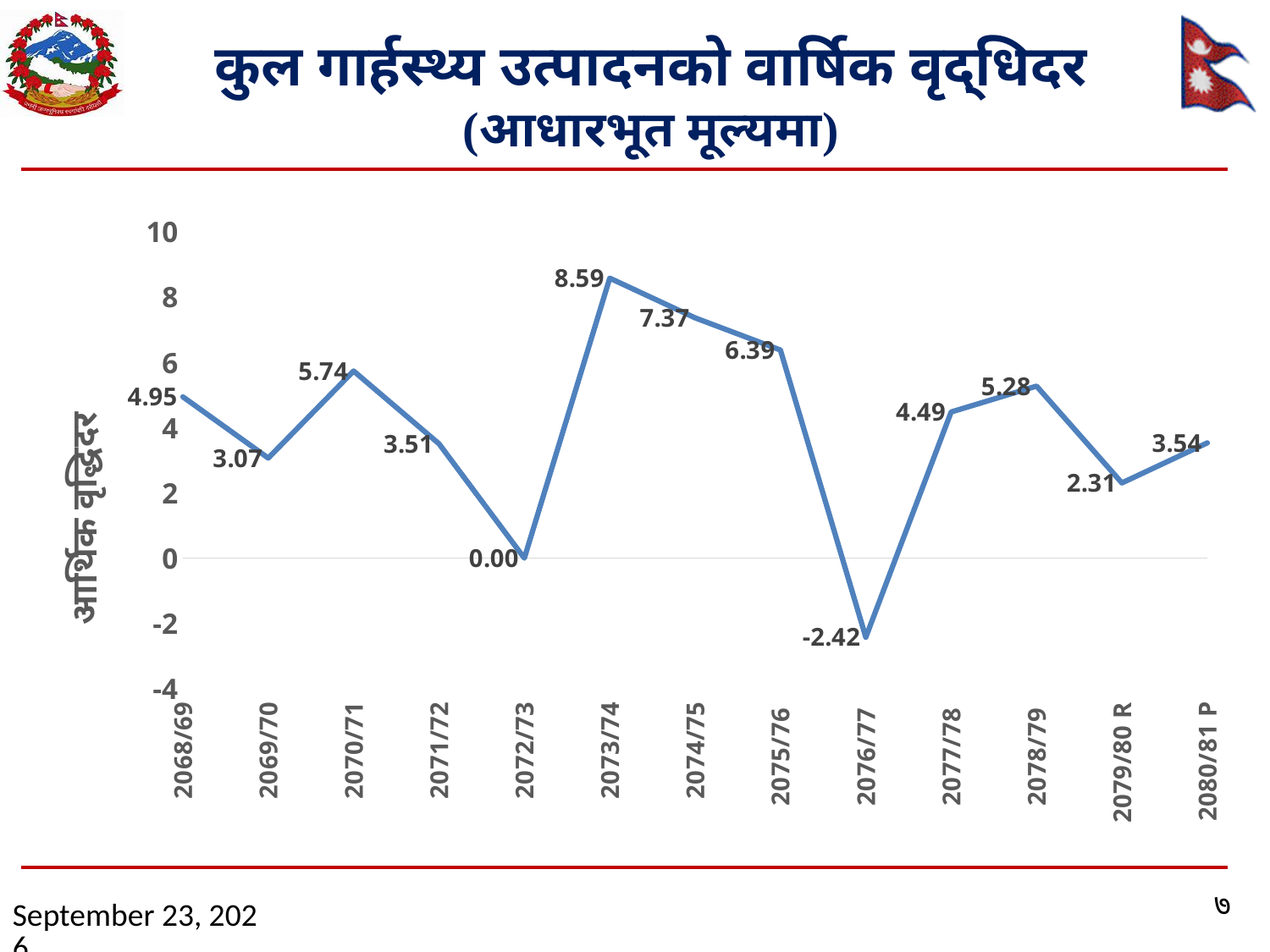
How many years are plotted on the x axis? 13 Which year has the lowest value? 2076/77 Do the values rise or fall from 2079/80 R to 2080/81 P? rise What is the value for 2080/81 P? 3.54 Is the value for 2075/76 greater or less than 6? greater Which year has the highest value? 2073/74 What is the difference between the values for 2073/74 and 2074/75? 1.22 What is the value for 2076/77? -2.42 What is the difference between the values for 2078/79 and 2079/80 R? 2.97 What kind of chart is shown on the slide? line chart What is the value for 2073/74? 8.59 Which is larger, the value for 2070/71 or the value for 2071/72? 2070/71